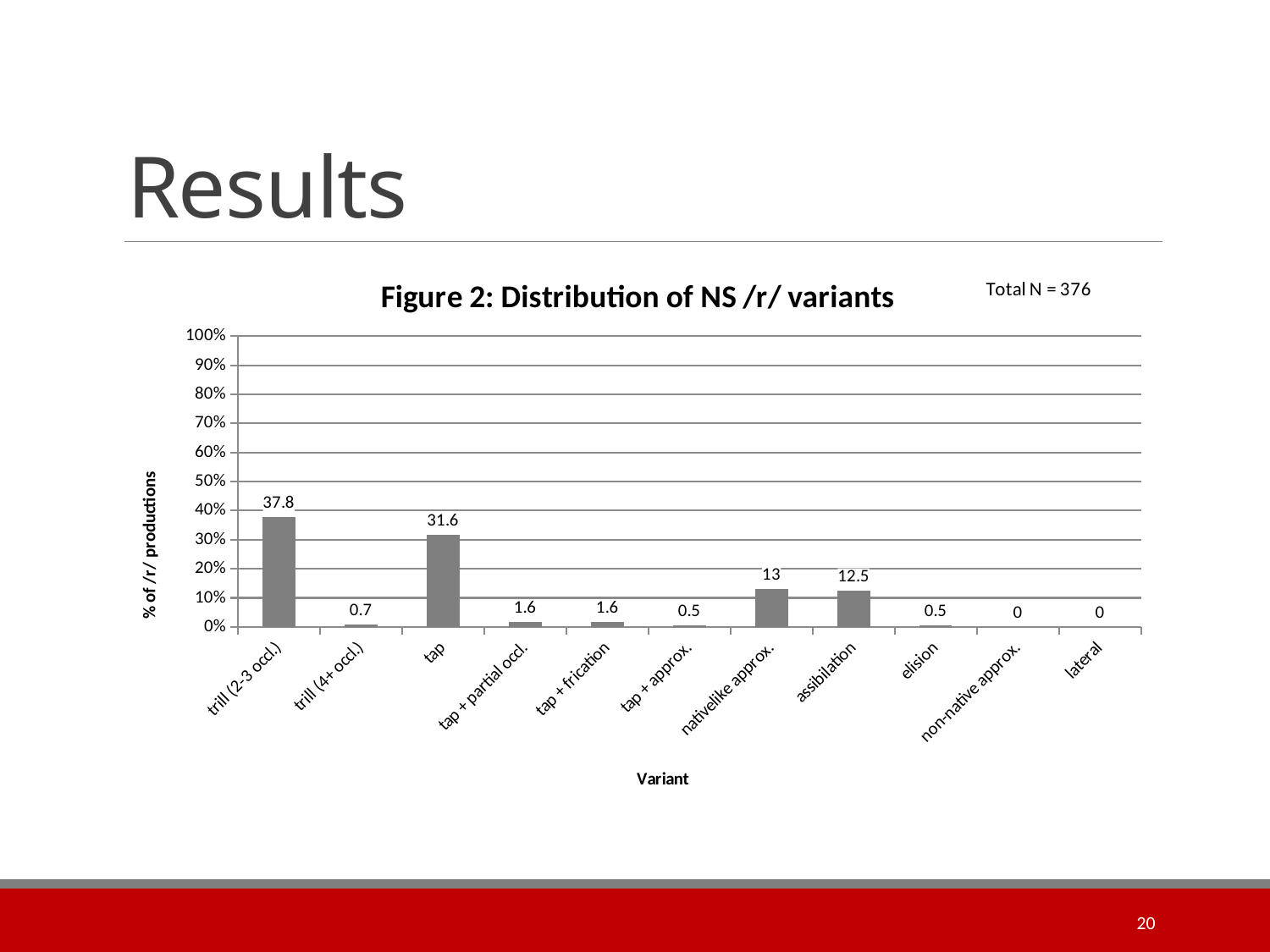
How many variant categories are shown on the x axis of Figure 2? 11 What is the value for nativelike approx. in Figure 2? 13 What is the difference between the values for trill (2-3 occl.) and tap in Figure 2? 6.2 Which variant has the highest value in Figure 2? trill (2-3 occl.) What kind of chart is Figure 2? bar chart What is the total N stated next to the title of Figure 2? 376 What is the value for assibilation in Figure 2? 12.5 How many variants in Figure 2 have a value of 0? 2 Is the value for tap in Figure 2 greater or less than 20%? greater What is the value for trill (2-3 occl.) in Figure 2? 37.8 Which is larger in Figure 2, the value for nativelike approx. or the value for assibilation? nativelike approx. What is the value for tap in Figure 2? 31.6